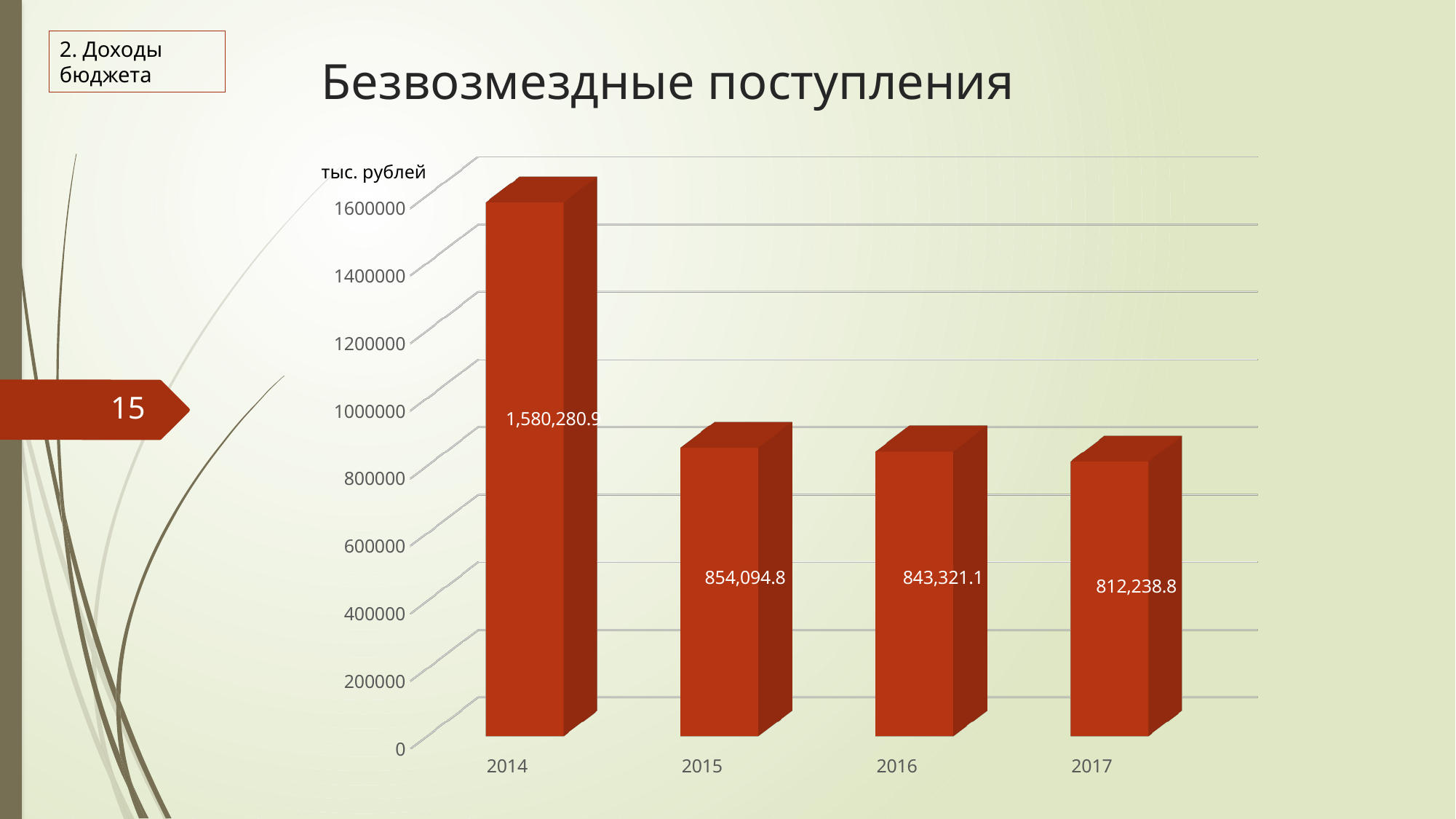
Which year has the lowest value? 2017 Which year has the highest value? 2014 What is the value for 2016? 843,321.1 What is the difference between the values for 2014 and 2015? 726,186.1 What is the value for 2014? 1,580,280.9 What is the value for 2017? 812,238.8 How many years are shown on the x axis? 4 Is the value for 2017 greater or less than 1000000? less What is the difference between the values for 2016 and 2017? 31,082.3 What unit is indicated for the values on the chart? тыс. рублей Which is larger, the value for 2015 or the value for 2016? 2015 What kind of chart is shown on the slide? bar chart